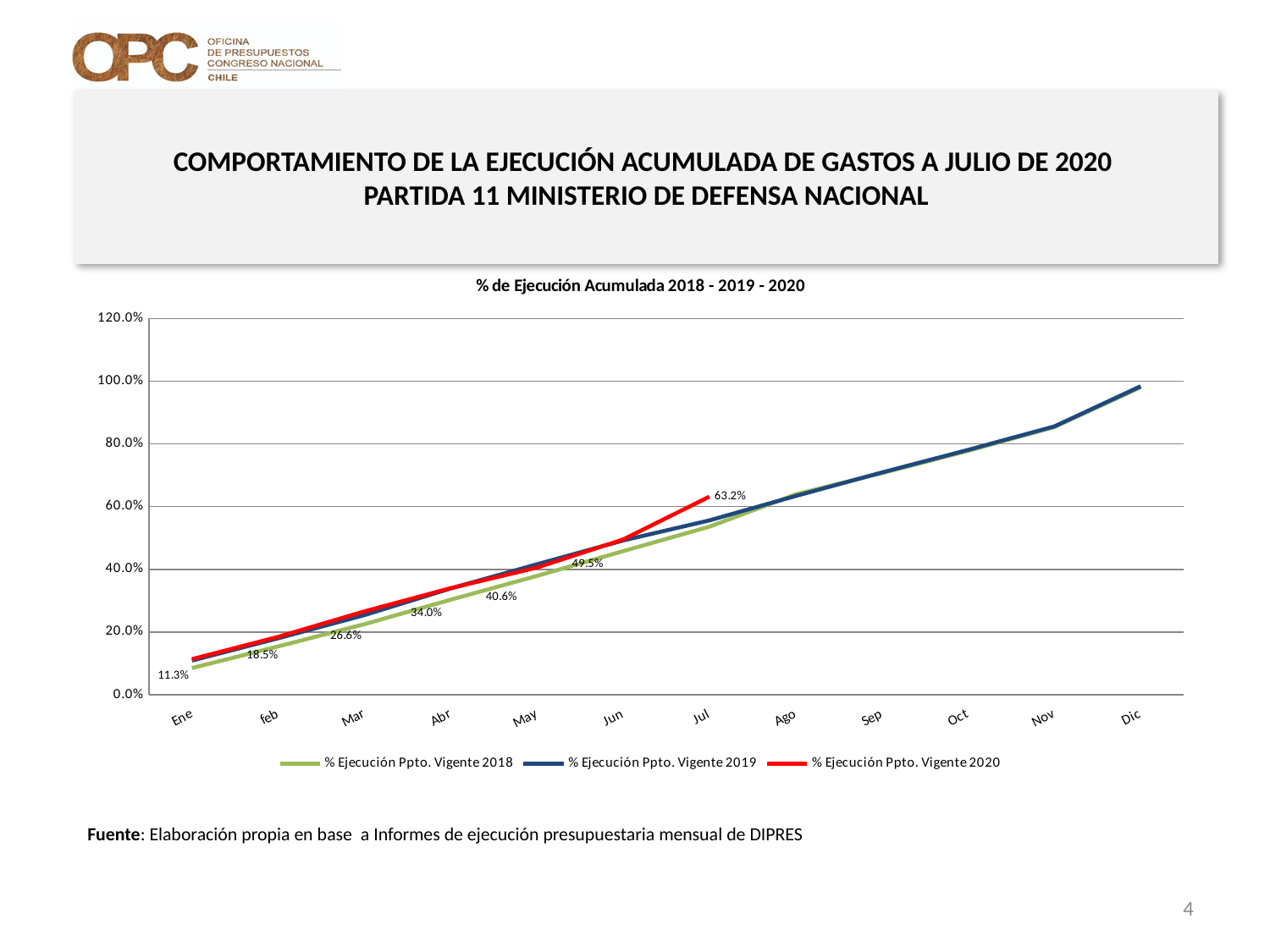
What is the value labelled at Jul for % Ejecución Ppto. Vigente 2020? 63.2% Do the values for % Ejecución Ppto. Vigente 2019 rise or fall from Ene to Dic? rise At Jul, which series has the higher value: % Ejecución Ppto. Vigente 2020 or % Ejecución Ppto. Vigente 2018? % Ejecución Ppto. Vigente 2020 Is the value for % Ejecución Ppto. Vigente 2018 at Dic greater or less than 80.0%? greater What is the title of the chart? % de Ejecución Acumulada 2018 - 2019 - 2020 What kind of chart is shown on the slide? line chart What is the difference between the labelled values at Jul (63.2%) and Jun (49.5%)? 13.7 percentage points How many months are shown on the x axis? 12 What value is labelled at May on the chart? 40.6% What value is labelled at Ene on the chart? 11.3% How many series does the legend list? 3 What value is labelled at Mar on the chart? 26.6%